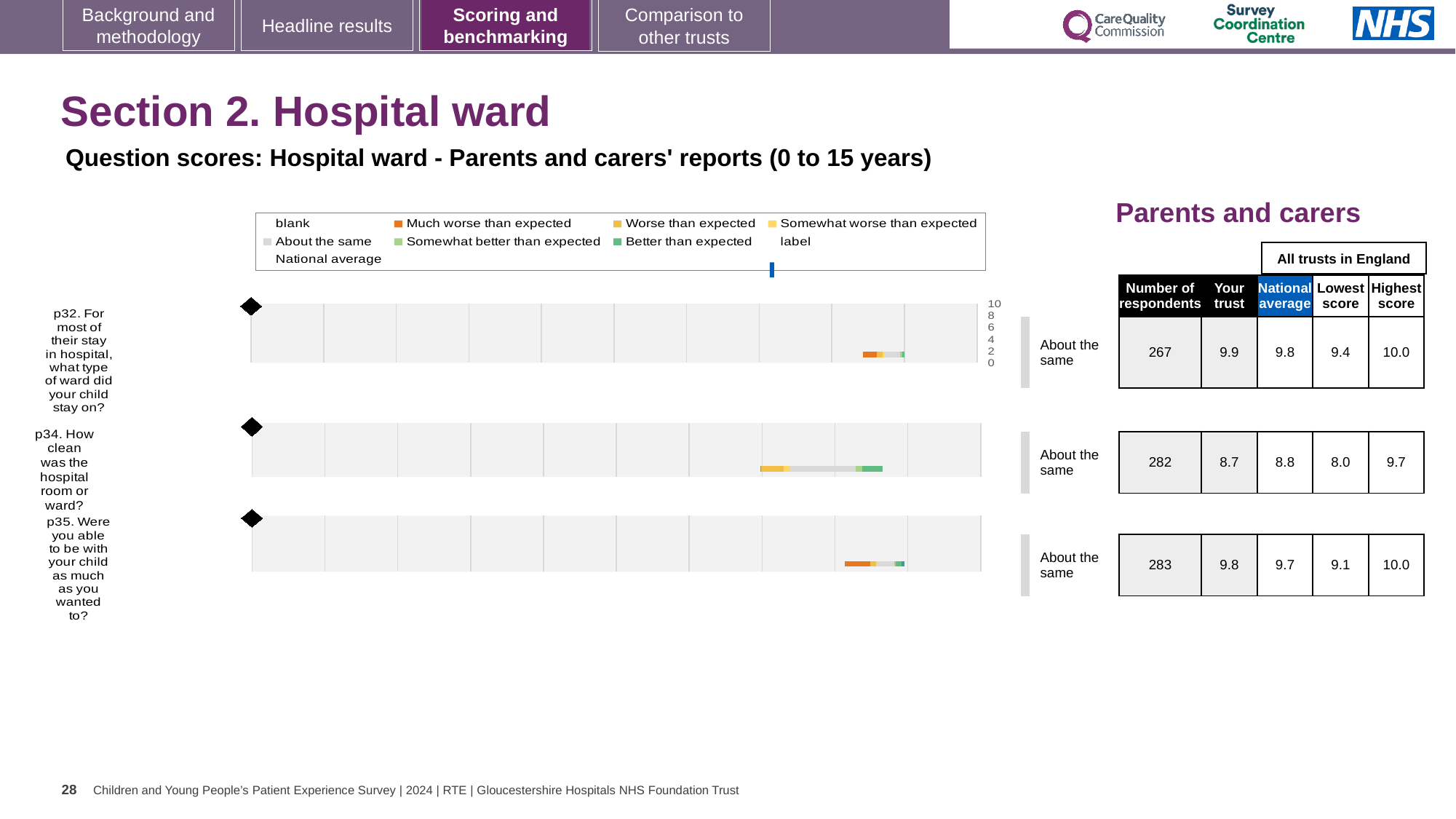
What is the lowest score among all trusts in England for question p32? 9.4 What is the 'Your trust' score for question p32 (what type of ward did your child stay on)? 9.9 What benchmark category is shown for question p35? About the same Which has the higher 'Your trust' score, question p32 or question p35? p32 What is the national average score for question p35 (were you able to be with your child as much as you wanted to)? 9.7 What is the difference between the national average and the 'Your trust' score for question p34? 0.1 How many questions are plotted on this slide? 3 What kind of chart is used to show the question scores? Bar chart Which question has the lowest 'Your trust' score? p34. How clean was the hospital room or ward? What is the highest score among all trusts in England for question p34? 9.7 How many respondents answered question p34 (How clean was the hospital room or ward?)? 282 What is the difference between the highest and lowest scores among all trusts in England for question p35? 0.9